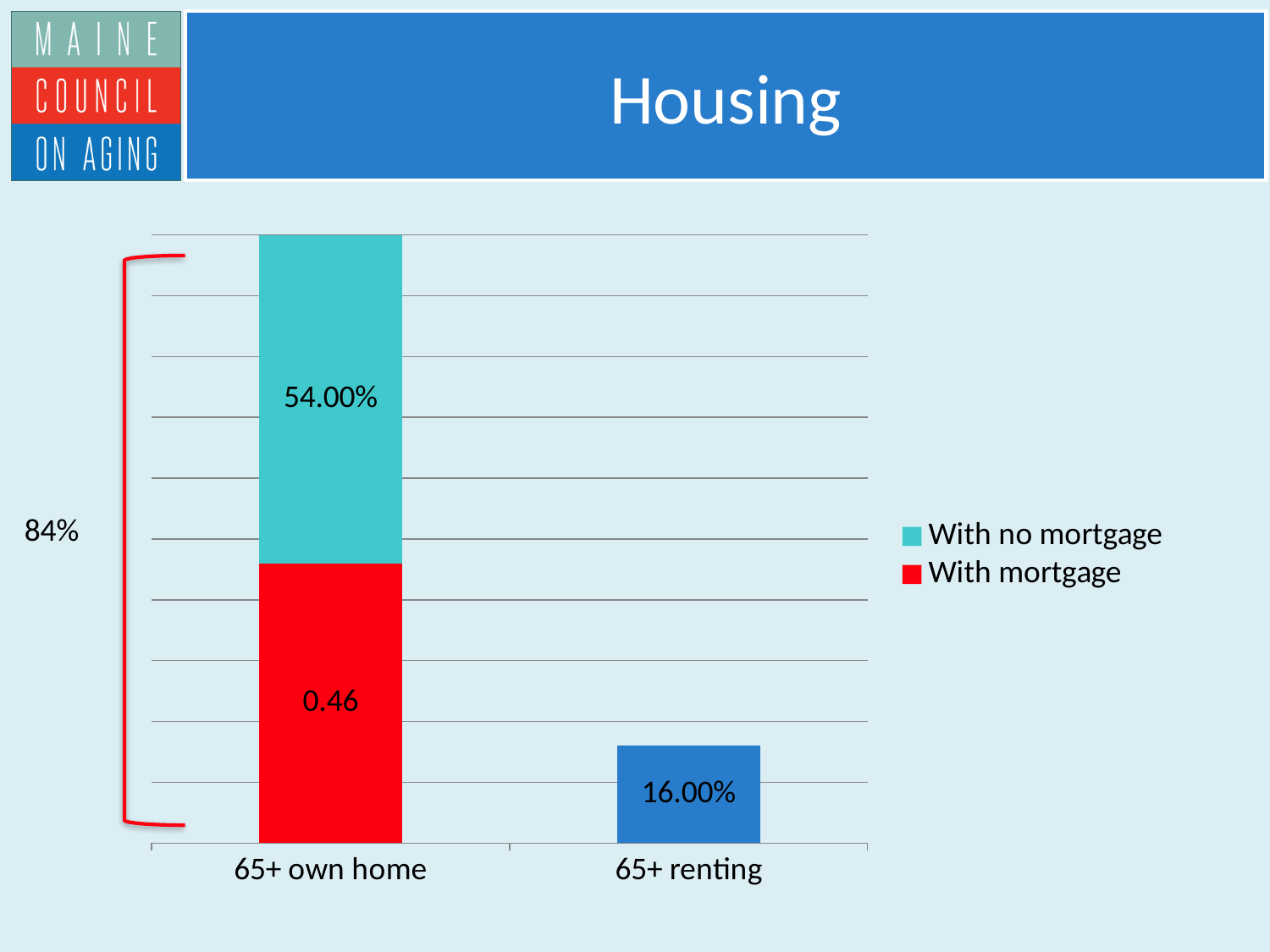
How many categories are shown on the x axis? 2 What is the title of the slide containing the chart? Housing Which category has the taller bar, '65+ own home' or '65+ renting'? 65+ own home What are the two series named in the legend? With no mortgage; With mortgage How many series does the chart legend list? 2 What is the data label for the 'With mortgage' segment of the '65+ own home' bar? 0.46 What is the data label shown on the '65+ renting' bar? 16.00% What percentage is written next to the red bracket spanning the '65+ own home' bar? 84% Which category has the lowest bar? 65+ renting What kind of chart is shown on the slide? stacked bar chart What is the data label for the 'With no mortgage' segment of the '65+ own home' bar? 54.00% Within the '65+ own home' bar, which segment is larger, 'With no mortgage' or 'With mortgage'? With no mortgage